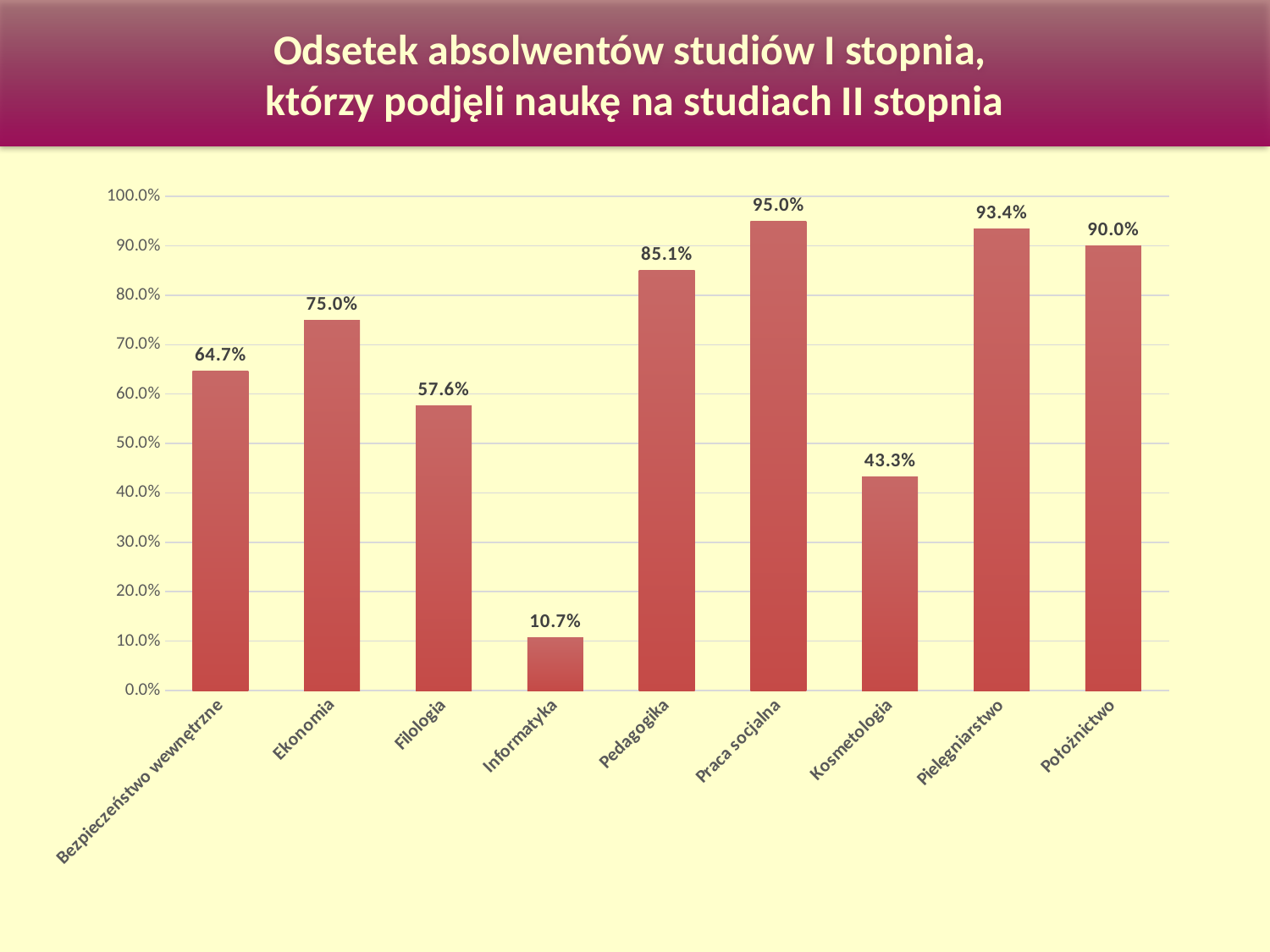
What is the title of the chart? Odsetek absolwentów studiów I stopnia, którzy podjęli naukę na studiach II stopnia Which category has the lowest value? Informatyka Is the value for Filologia greater or less than 60.0%? less What is the difference between the values for Pielęgniarstwo and Położnictwo? 3.4% How many categories are shown on the x axis? 9 What is the value for Bezpieczeństwo wewnętrzne? 64.7% What kind of chart is shown on the slide? bar chart What is the difference between the values for Praca socjalna and Informatyka? 84.3% What is the value for Ekonomia? 75.0% Which is larger, the value for Pedagogika or the value for Filologia? Pedagogika Which category has the highest value? Praca socjalna What is the value for Kosmetologia? 43.3%